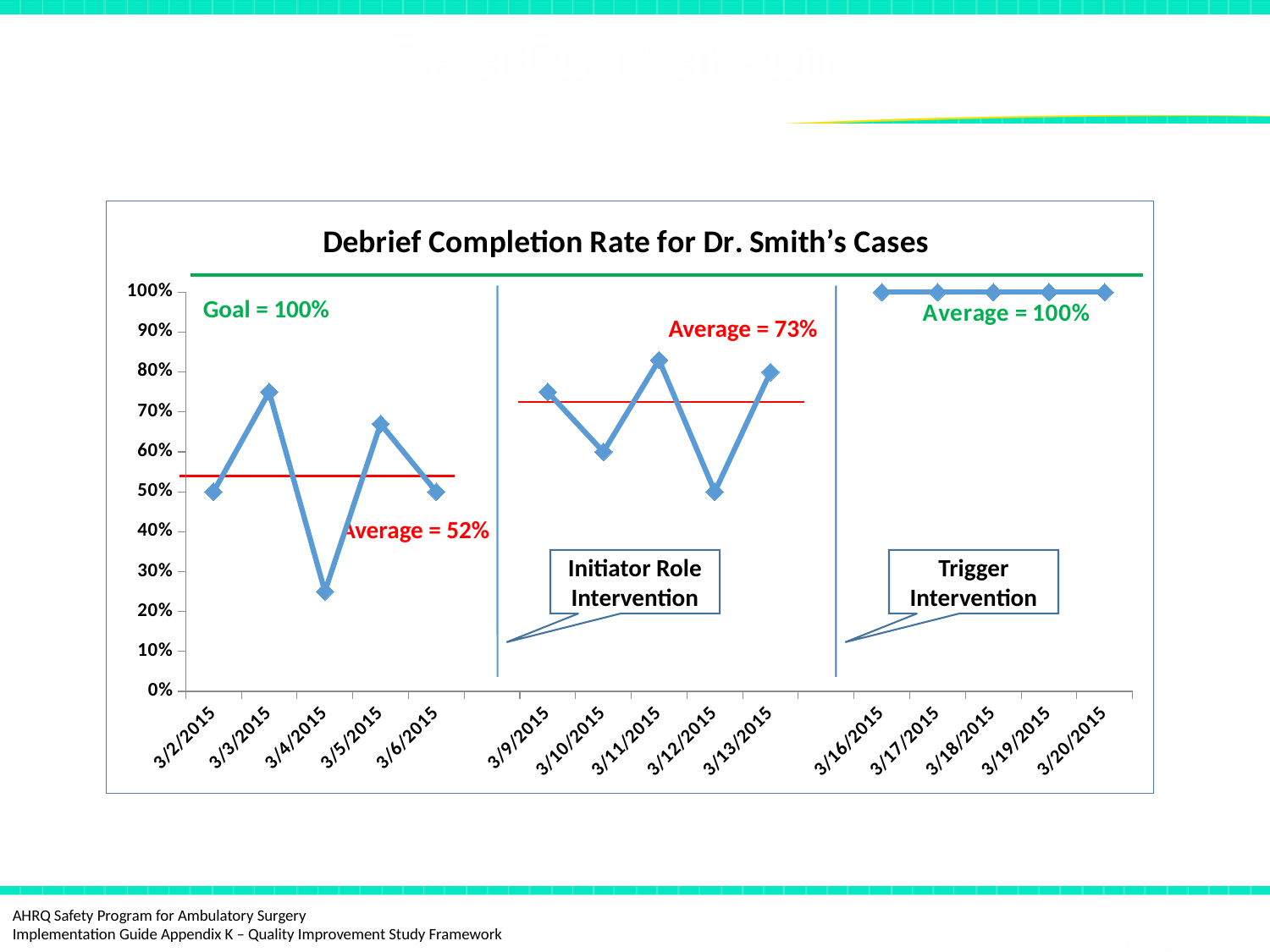
Which date has the lowest debrief completion rate? 3/4/2015 What is the title of the chart? Debrief Completion Rate for Dr. Smith's Cases Is the value for 3/4/2015 greater or less than 30%? less Which is larger, the value for 3/3/2015 or the value for 3/4/2015? 3/3/2015 How many dates are plotted on the x axis of the chart? 15 What is the goal value shown on the chart? 100% What is the average debrief completion rate shown after the Trigger Intervention? 100% What is the average debrief completion rate shown for the first period (3/2/2015 to 3/6/2015)? 52% What is the average debrief completion rate shown after the Initiator Role Intervention? 73% What is the debrief completion rate on 3/20/2015? 100% Is the value for 3/11/2015 greater or less than 80%? greater What kind of chart is shown on the slide? line chart